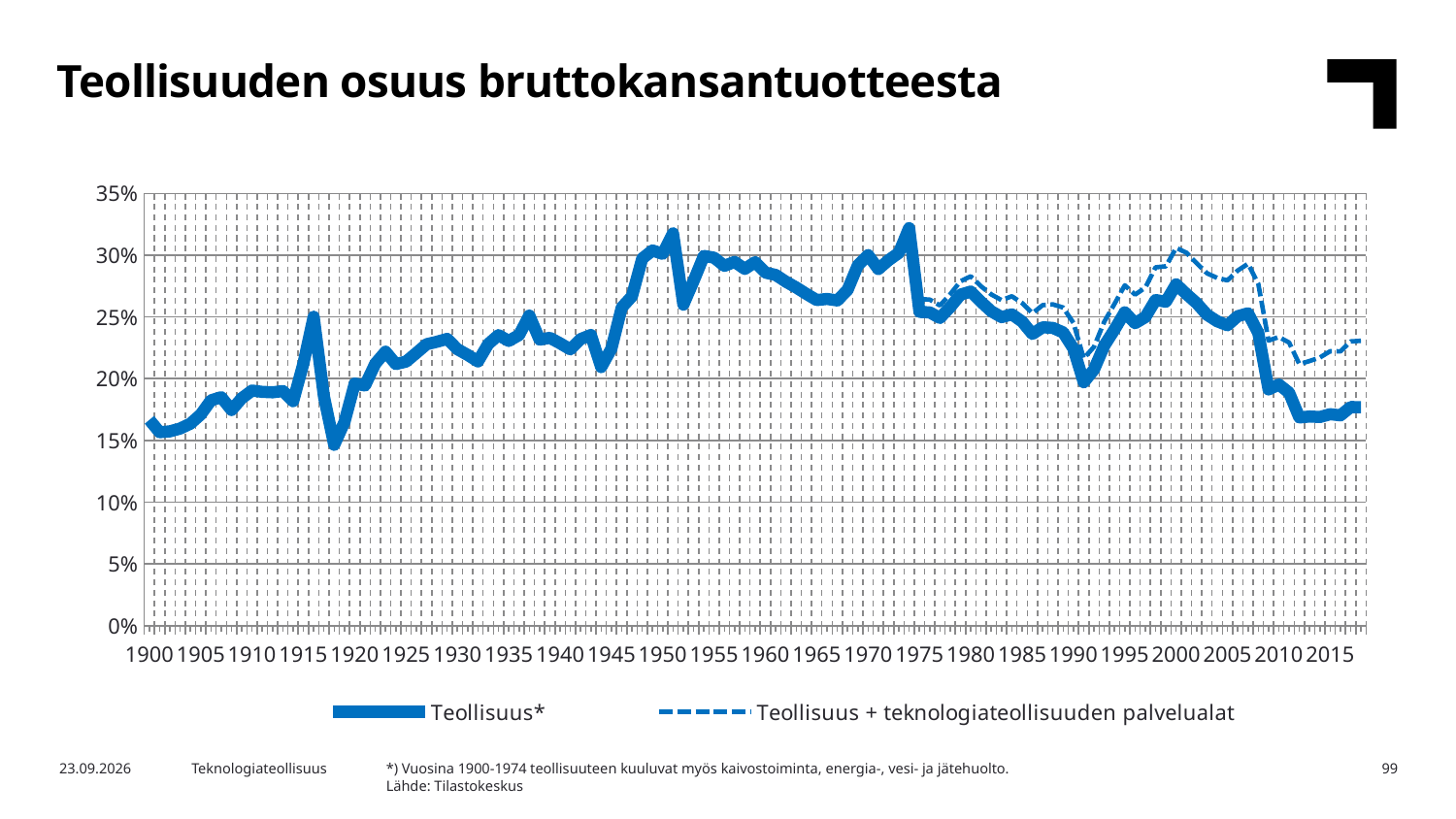
In 2015, which series has the higher value, Teollisuus* or Teollisuus + teknologiateollisuuden palvelualat? Teollisuus + teknologiateollisuuden palvelualat Is the value for Teollisuus + teknologiateollisuuden palvelualat in 2010 greater or less than 25%? less What kind of chart is shown on the slide? Line chart Which series is drawn with a dashed line? Teollisuus + teknologiateollisuuden palvelualat What is the title of the chart? Teollisuuden osuus bruttokansantuotteesta Does the Teollisuus* series rise or fall between 1900 and 1915? Rise How many series does the legend list? 2 Is the value for Teollisuus + teknologiateollisuuden palvelualat in 2000 greater or less than 25%? greater Is the value for Teollisuus* in 1900 greater or less than 20%? less Does the Teollisuus* series rise or fall between 2005 and 2015? Fall